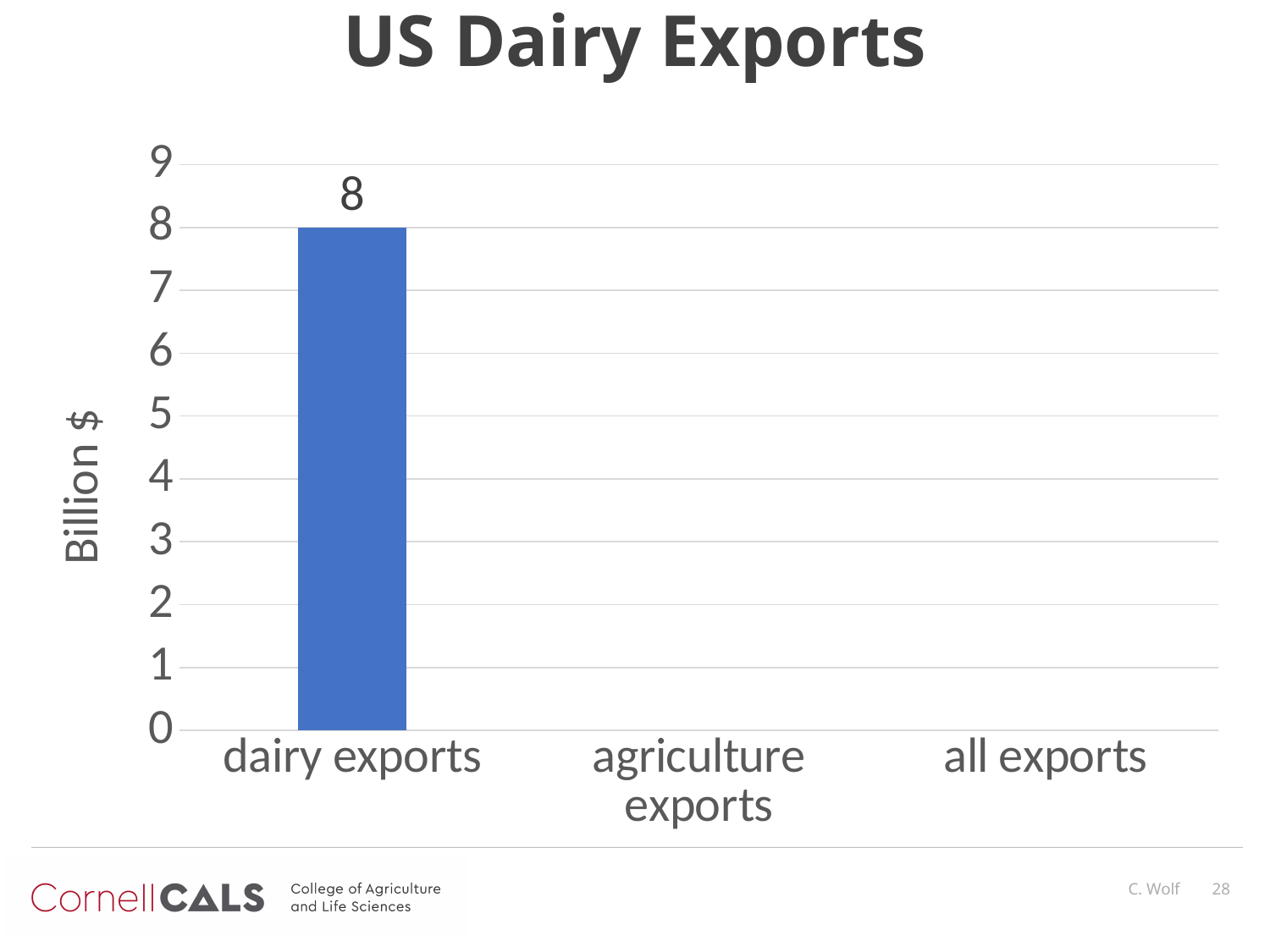
What is the label on the y axis? Billion $ What is the value for dairy exports? 8 Is the value for dairy exports greater or less than 9? less What is the highest value shown on the y axis? 9 What is the title of the chart? US Dairy Exports What kind of chart is shown on the slide? bar chart How many categories are labelled on the x axis? 3 Is the value for dairy exports greater or less than 5? greater